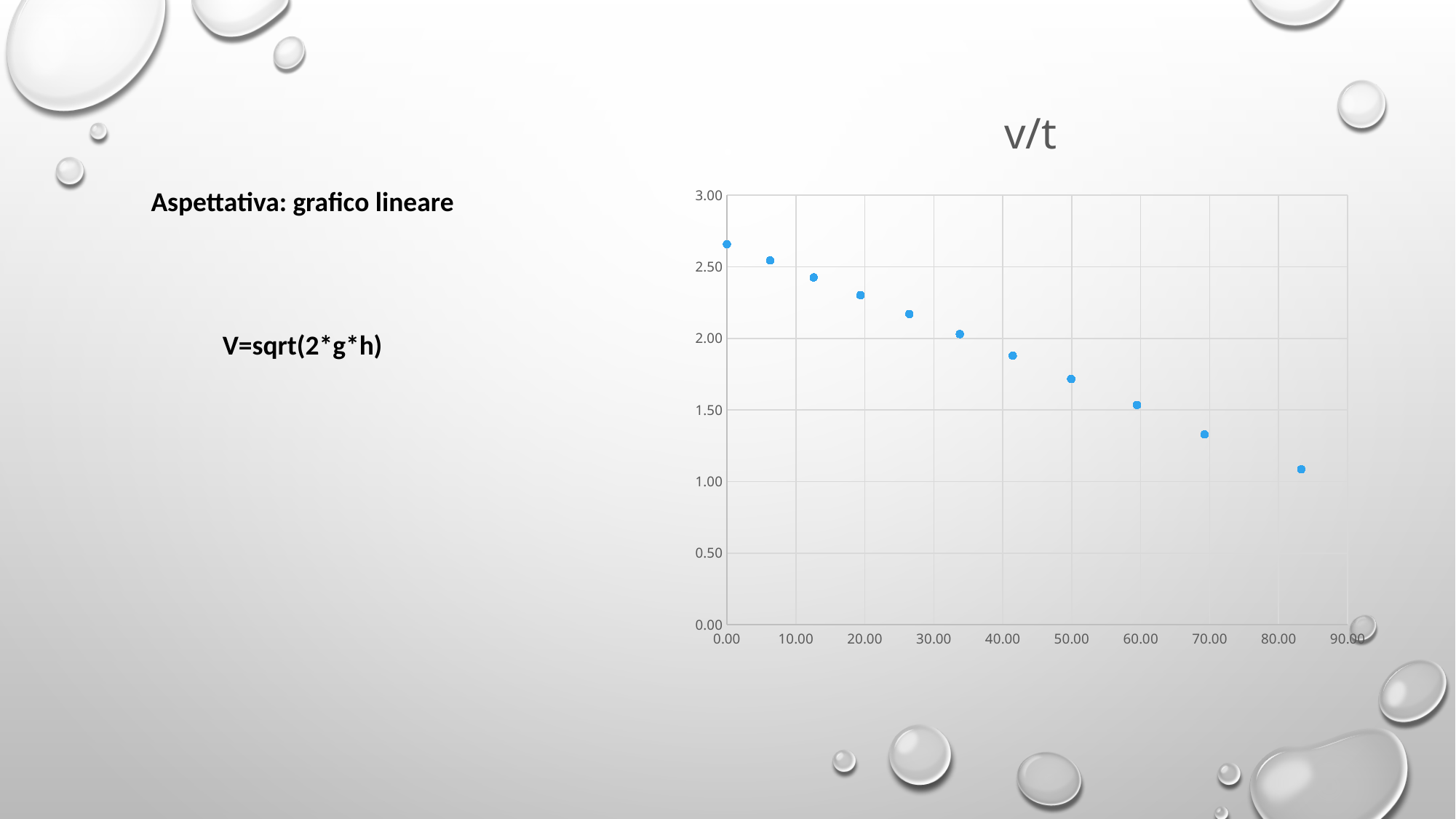
Is the value of the last point (near x = 83) greater or less than 1.50? less What is the maximum value shown on the vertical axis? 3.00 How many data points are plotted in the chart? 11 Is the value of the point near x = 50.00 greater or less than 2.00? less Is the value of the point near x = 70.00 greater or less than 1.50? less What kind of chart is shown on the slide? scatter chart What is the title of the chart? v/t Which point has the highest value: the one at x = 0.00 or the one near x = 83? the one at x = 0.00 Do the plotted values rise or fall as the x value increases? fall